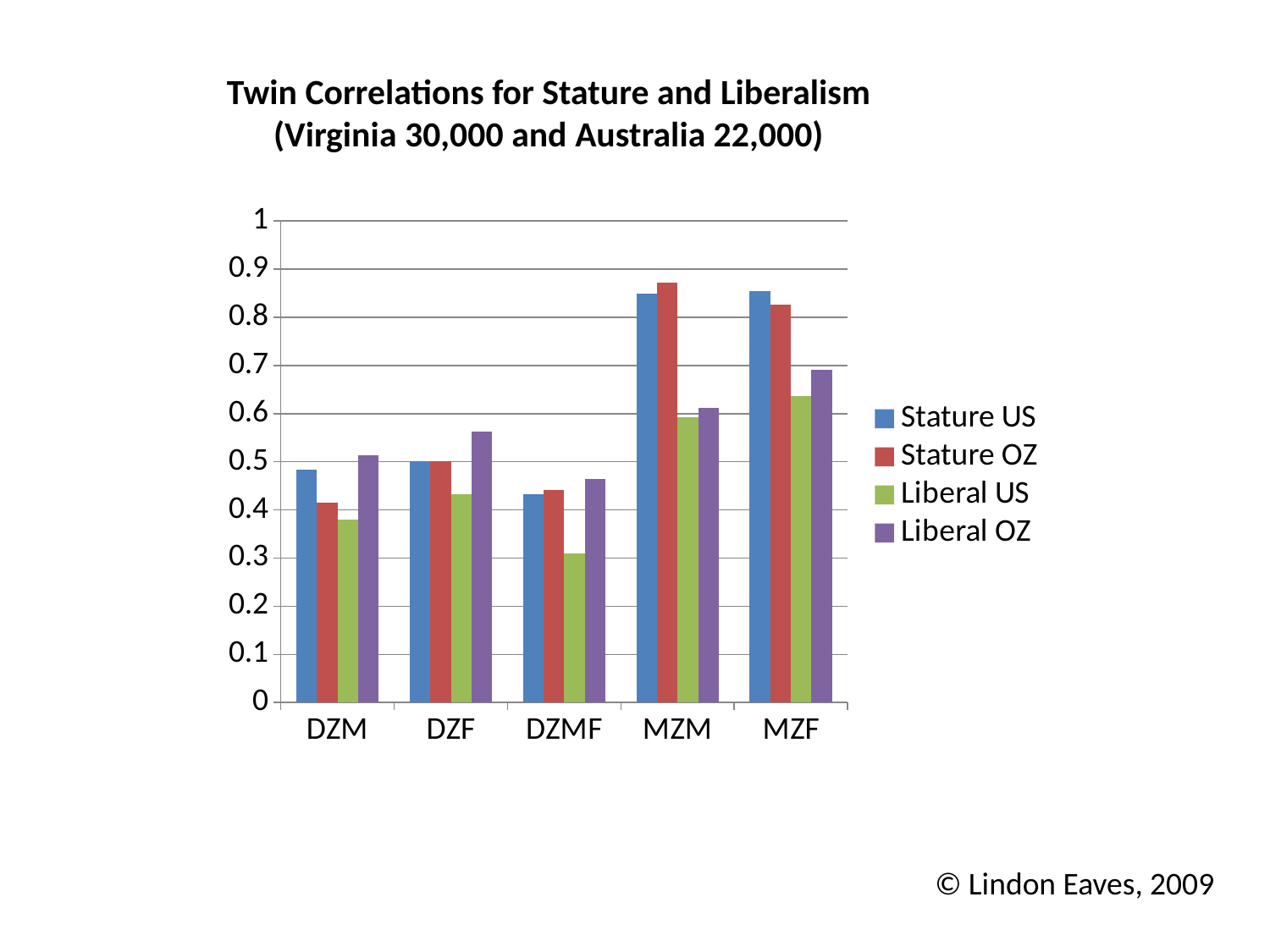
For MZF, which is larger: Liberal OZ or Liberal US? Liberal OZ Which category has the lowest Liberal US value? DZMF For DZM, which is larger: Stature US or Liberal US? Stature US What kind of chart is shown on the slide? bar chart How many series does the legend list? 4 Which category has the highest Liberal OZ value? MZF How many categories are shown on the x axis? 5 Which category has the highest Stature OZ value? MZM Is the Liberal US value for DZMF greater or less than 0.4? less Is the Stature OZ value for MZM greater or less than 0.8? greater Is the Liberal OZ value for DZF greater or less than 0.5? greater What colour represents the Liberal US series in the legend? green